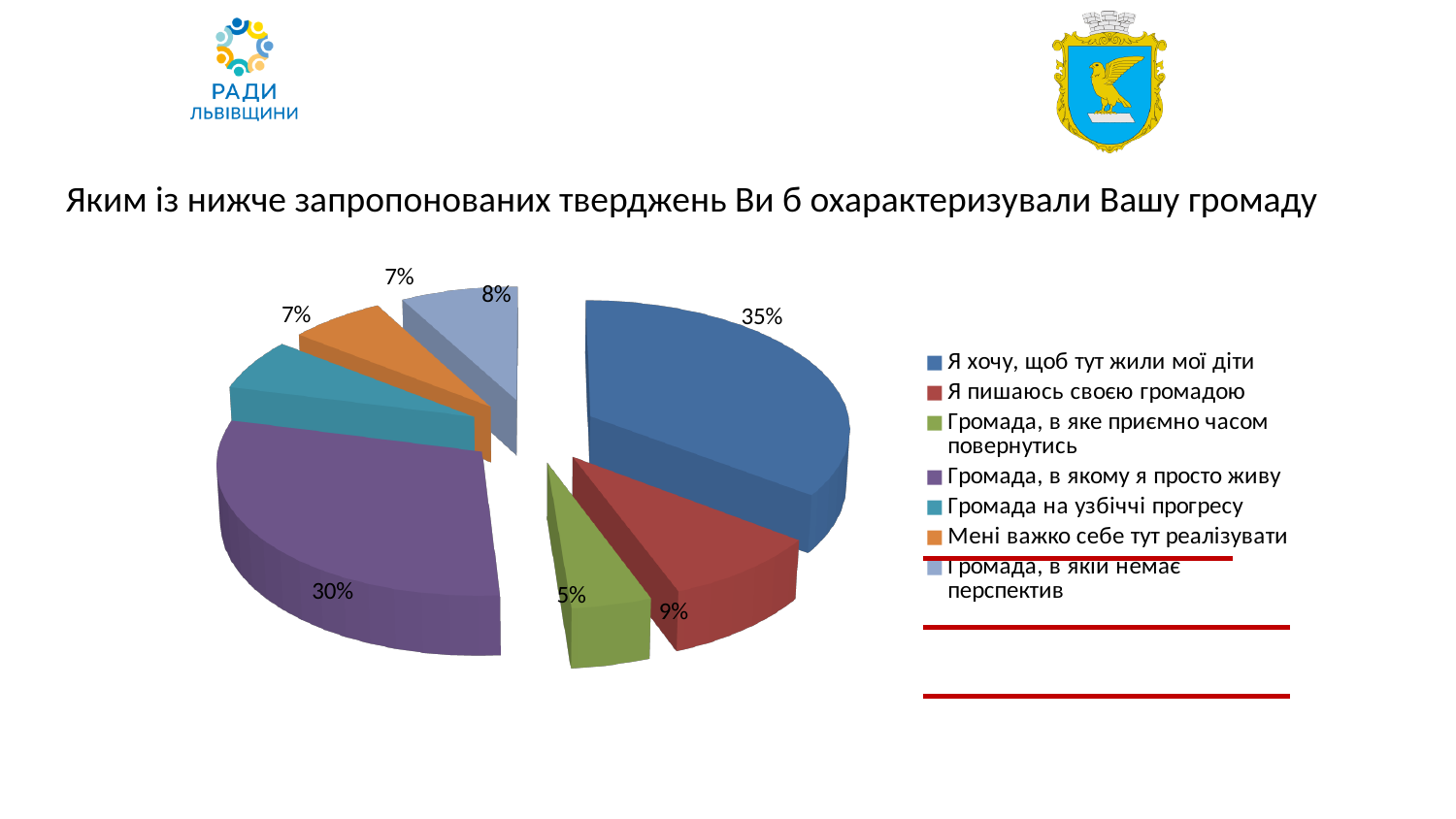
Which category has the smallest slice of the pie? Громада, в яке приємно часом повернутись Which category has the largest slice of the pie? Я хочу, щоб тут жили мої діти What is the title of the chart? Яким із нижче запропонованих тверджень Ви б охарактеризували Вашу громаду How many categories does the legend list? 7 What is the value for "Я пишаюсь своєю громадою"? 9% What is the value for "Громада, в якій немає перспектив"? 8% What share of the pie does "Громада, в якому я просто живу" have? 30% What is the difference between the shares of "Я хочу, щоб тут жили мої діти" and "Громада, в якому я просто живу"? 5% What share of the pie does "Я хочу, щоб тут жили мої діти" have? 35% Which is larger: the share for "Я пишаюсь своєю громадою" or for "Громада, в якій немає перспектив"? Я пишаюсь своєю громадою What kind of chart is shown on the slide? Pie chart What is the value for "Громада, в яке приємно часом повернутись"? 5%